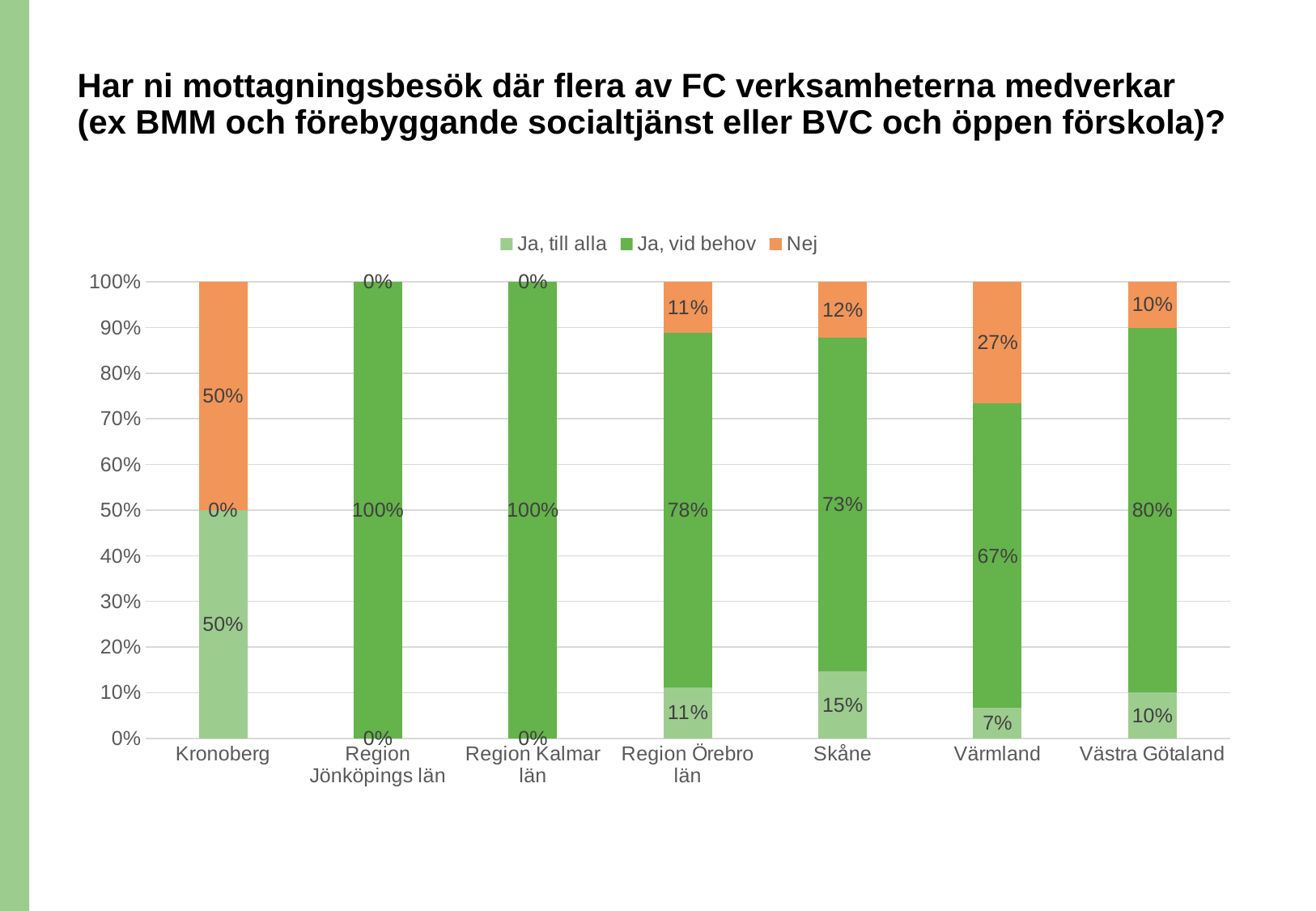
Which category has the highest value for "Ja, till alla"? Kronoberg How many series does the legend list? 3 Which series is shown in orange? Nej What is the value for "Nej" for Kronoberg? 50% What kind of chart is shown on the slide? Stacked bar chart How many categories are shown on the x axis? 7 Which is larger: the "Nej" value for Värmland or the "Nej" value for Skåne? Värmland What is the value for "Ja, till alla" for Skåne? 15% What is the value for "Nej" for Västra Götaland? 10% What is the difference between the "Ja, vid behov" values for Västra Götaland and Region Örebro län? 2% What is the value for "Ja, vid behov" for Värmland? 67% Which category has the highest value for "Nej"? Kronoberg